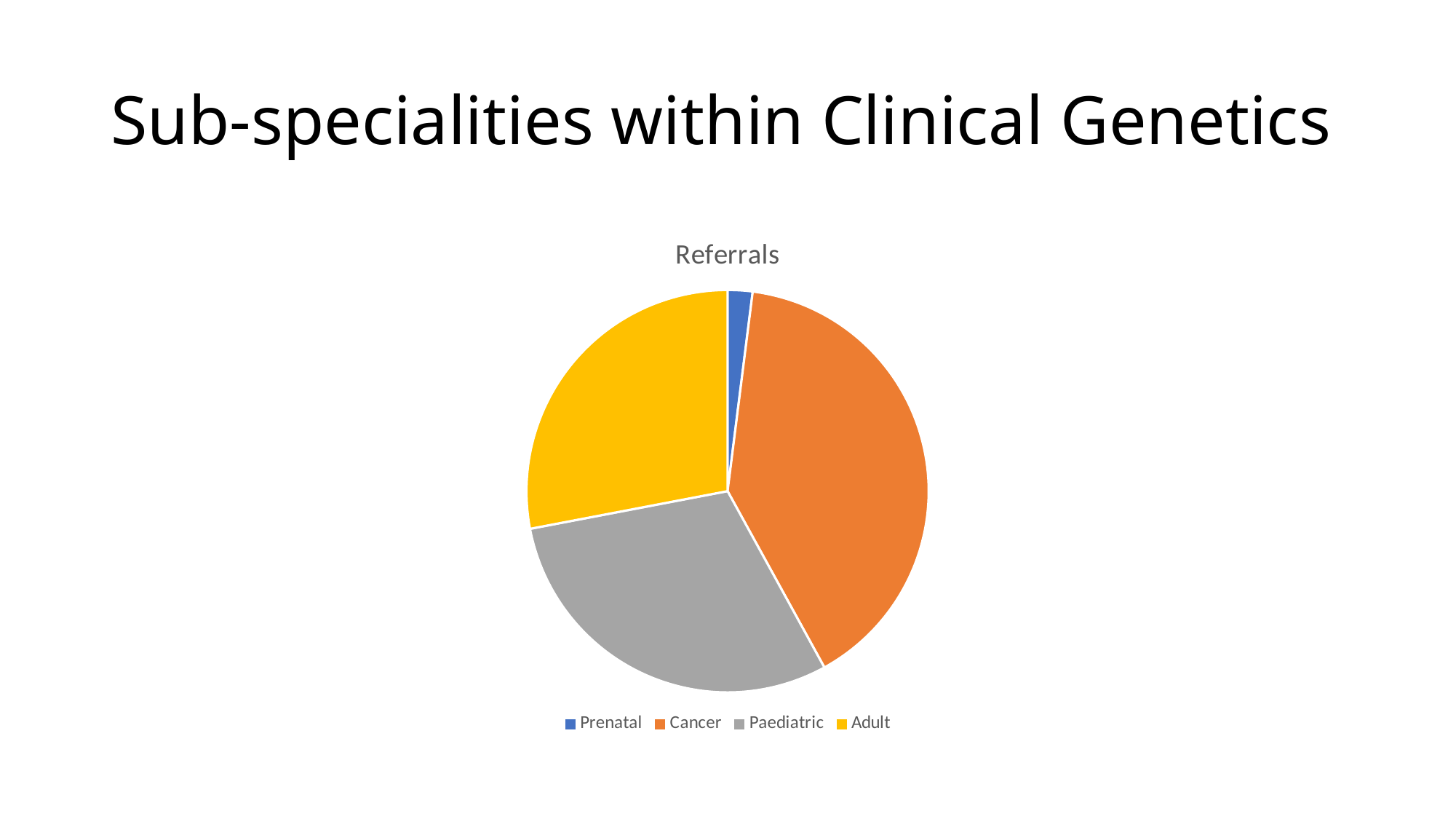
Which slice is larger, Cancer or Adult? Cancer What is the title of the chart? Referrals Which category has the largest slice of the pie? Cancer What colour is the Adult slice? yellow Which slice is larger, Paediatric or Prenatal? Paediatric Which category has the smallest slice of the pie? Prenatal Which category is represented by the grey slice? Paediatric How many categories does the pie chart show? 4 What kind of chart is shown on the slide? pie chart Which slice is larger, Cancer or Paediatric? Cancer